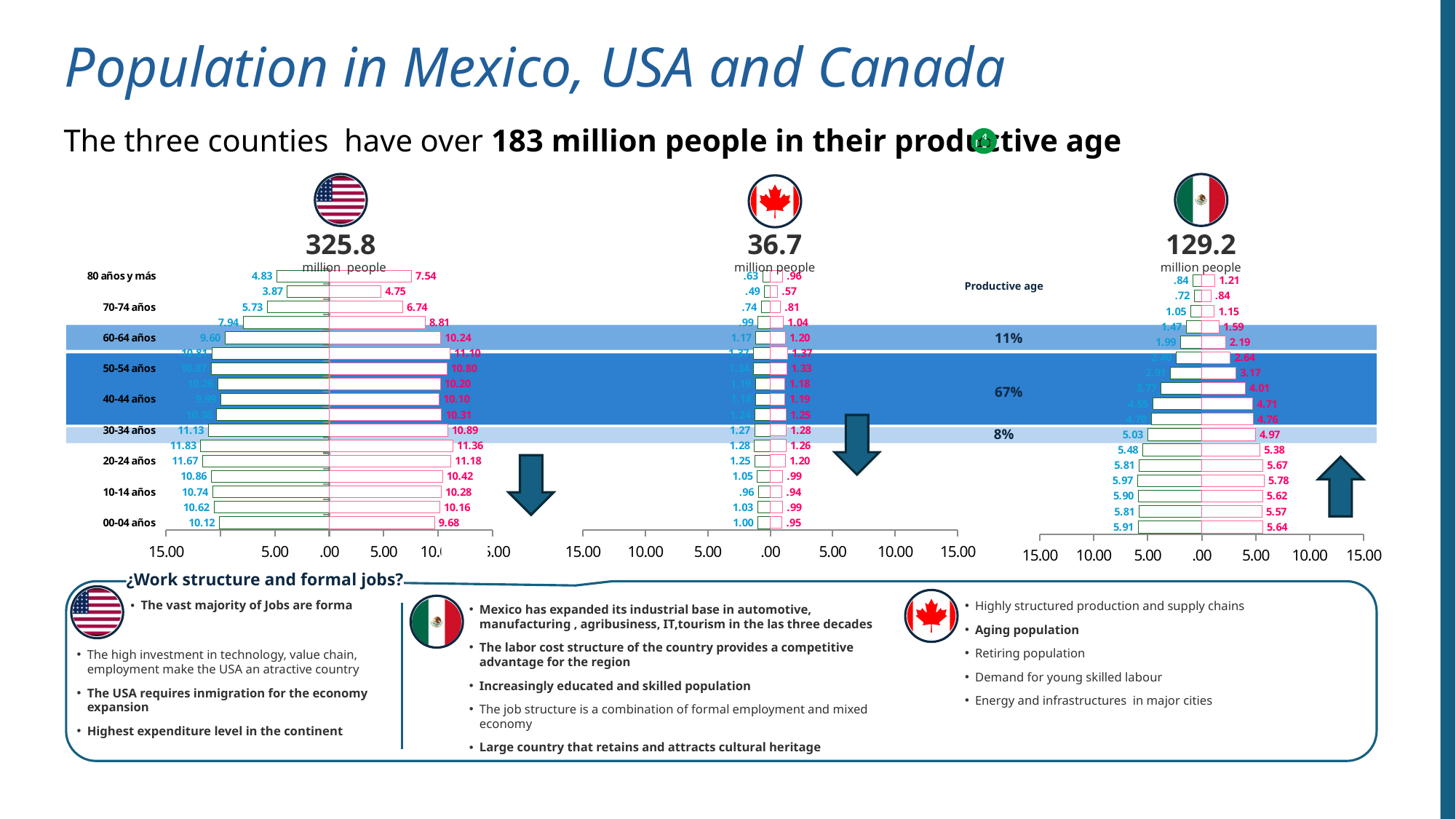
In the USA chart (left), what is the value of the blue bar for the 00-04 años age group? 10.12 What kind of chart is used to show the population of each country on the slide? bar chart In the Canada chart (middle), is the value of the pink bar for the 80 años y más age group greater or less than 5.00? less What percentage is shown for the 60-64 años band in the Productive age column? 11% What total population (in million people) is shown above the Canada chart? 36.7 In the Mexico chart (right), which is larger for the 10-14 años age group, the blue bar or the pink bar? the blue bar In the Mexico chart (right), is the value of the blue bar for the 20-24 años age group greater or less than 5.00? greater In the USA chart (left), what is the difference between the pink bar and the blue bar for the 80 años y más age group? 2.71 In the Mexico chart (right), what is the value of the blue bar for the 00-04 años age group? 5.91 In the Mexico chart (right), what is the value of the pink bar for the 60-64 años age group? 2.19 In the USA chart (left), what is the value of the pink bar for the 80 años y más age group? 7.54 In the Canada chart (middle), what is the value of the blue bar for the 20-24 años age group? 1.25